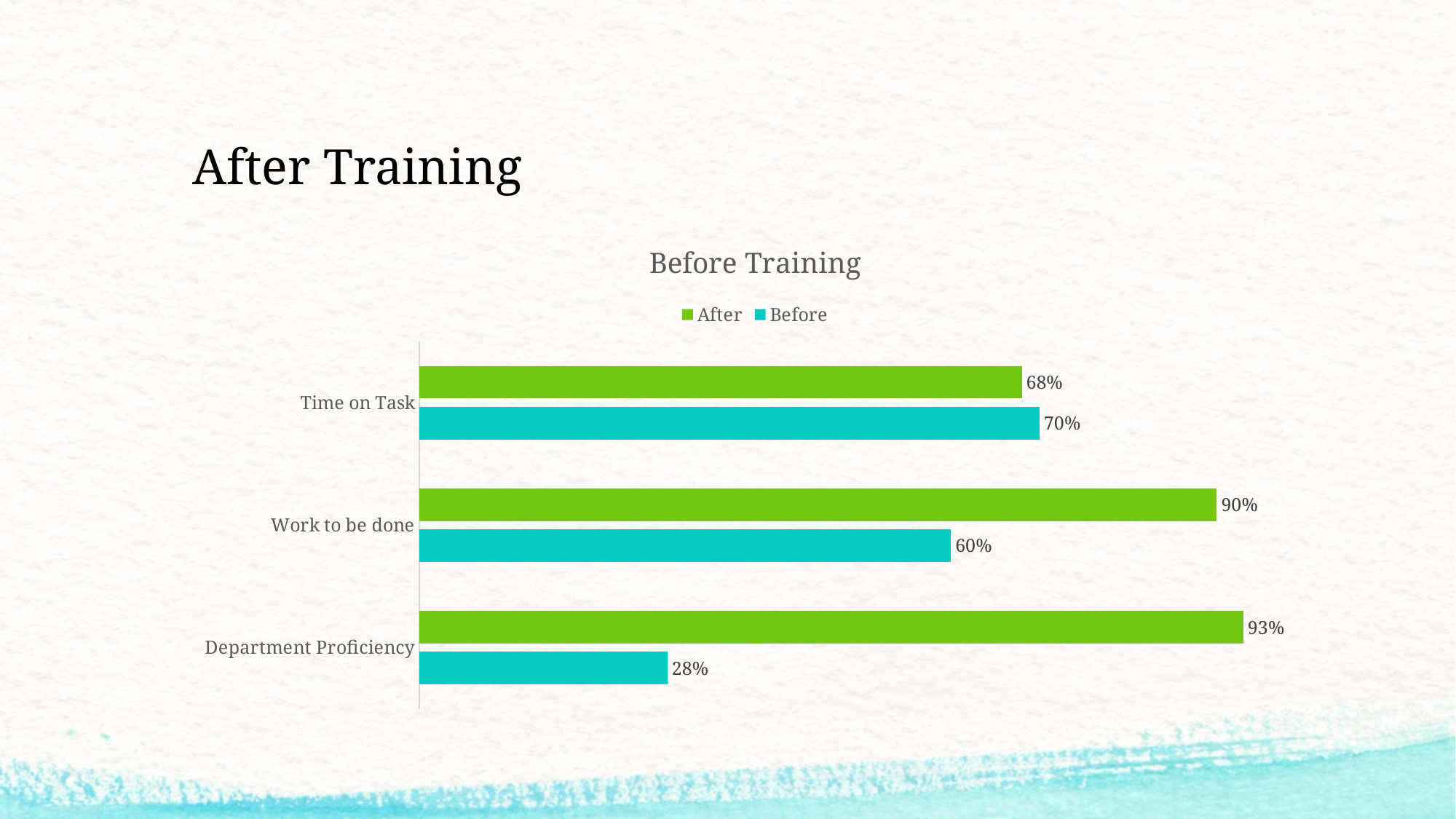
Which category has the highest After value? Department Proficiency How many series does the legend list? 2 What is the Before value for Time on Task? 70% For Time on Task, which is larger, the After value or the Before value? Before What is the Before value for Work to be done? 60% How many categories are shown on the chart? 3 What is the After value for Time on Task? 68% What is the After value for Department Proficiency? 93% What type of chart is shown on the slide? Bar chart What is the difference between the After and Before values for Work to be done? 30% What is the difference between the After and Before values for Department Proficiency? 65% Which category has the lowest Before value? Department Proficiency